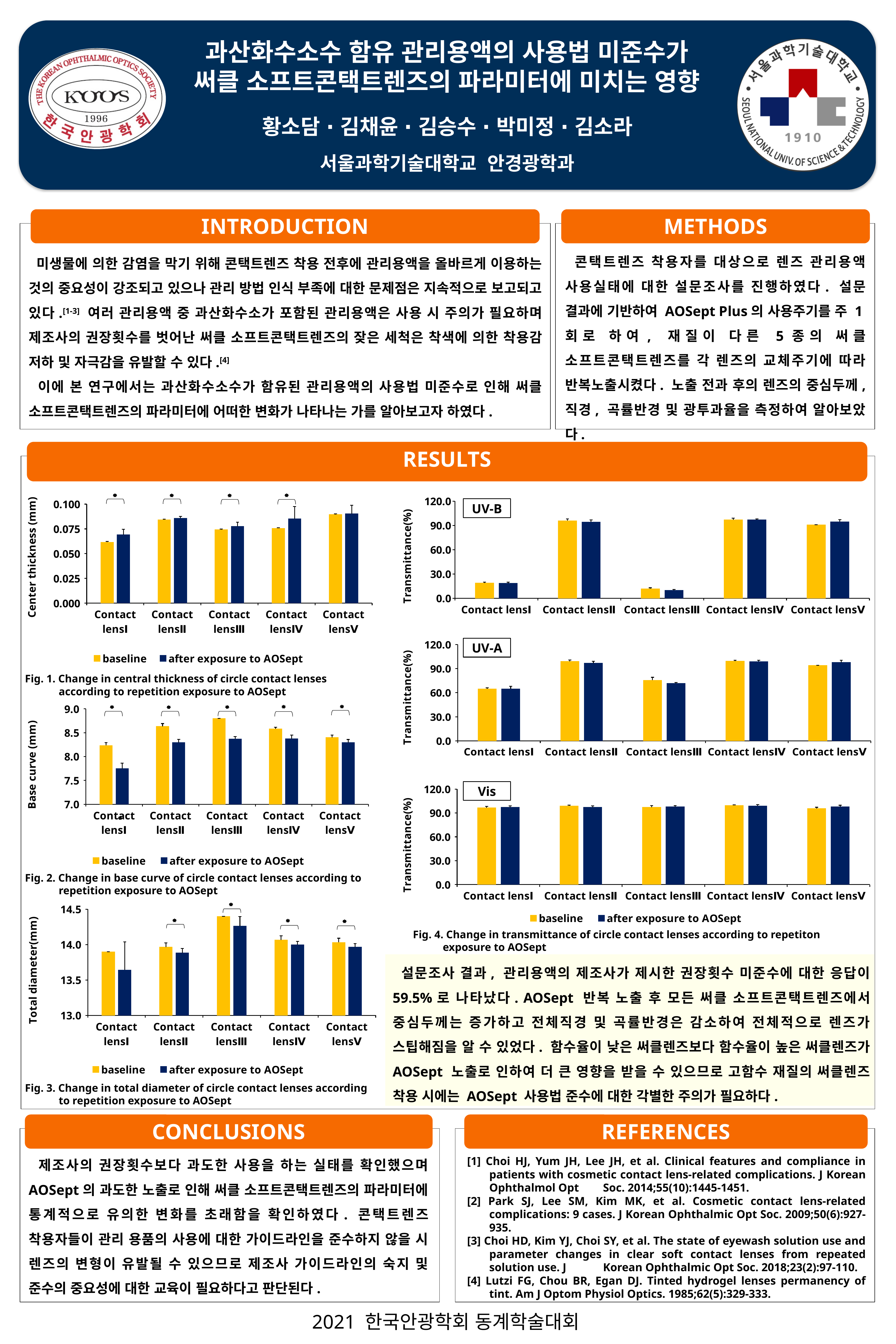
In the UV-B transmittance chart of Fig. 4, which contact lens has the lowest baseline transmittance? Contact lens III In Fig. 1 (center thickness), how many series does the legend list? 2 In Fig. 3 (total diameter), is the value after exposure to AOSept for Contact lens I greater or less than 14.0? less In Fig. 2 (base curve), which is larger for Contact lens I: the baseline value or the value after exposure to AOSept? baseline In the UV-A transmittance chart of Fig. 4, is the baseline value for Contact lens III greater or less than 60.0? greater In Fig. 1 (center thickness), is the baseline value for Contact lens I greater or less than 0.075? less What kind of chart is Fig. 3 (total diameter)? bar chart In Fig. 1 (center thickness), which is larger for Contact lens I: the baseline value or the value after exposure to AOSept? after exposure to AOSept In Fig. 3 (total diameter), which contact lens has the highest baseline value? Contact lens III In Fig. 1 (center thickness), how many contact lens categories are shown on the x axis? 5 In Fig. 2 (base curve), which contact lens has the highest baseline value? Contact lens III